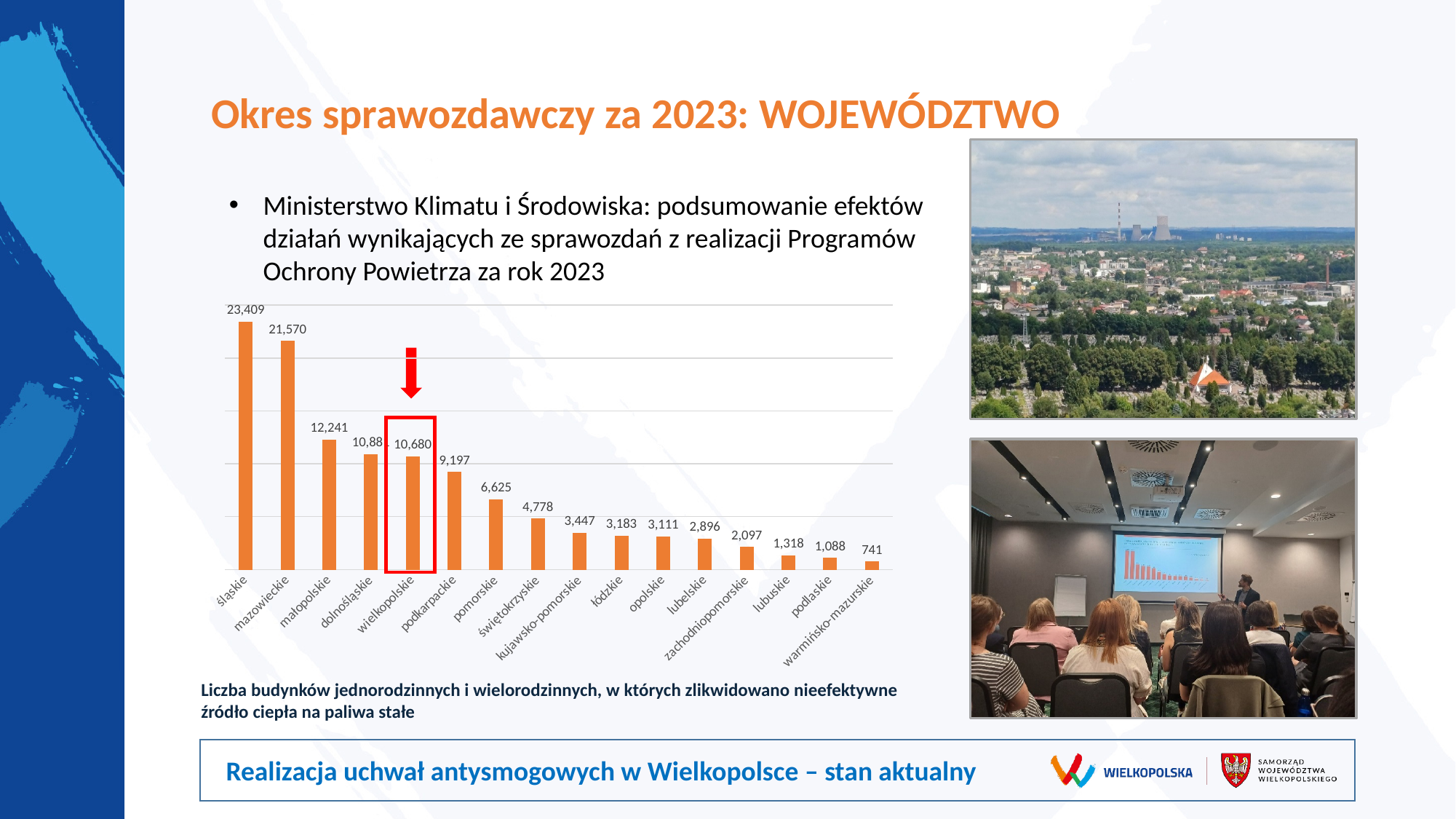
Which has a larger value, pomorskie or świętokrzyskie? pomorskie What is the value for podkarpackie in the bar chart? 9,197 How many voivodeships are shown in the bar chart? 16 What is the value for warmińsko-mazurskie in the bar chart? 741 Do the values rise or fall from left to right along the x axis? fall What is the value for wielkopolskie in the bar chart? 10,680 Which voivodeship has the lowest value in the bar chart? warmińsko-mazurskie What is the difference between the values for śląskie and mazowieckie? 1,839 What is the difference between the values for wielkopolskie and podkarpackie? 1,483 What is the value for śląskie in the bar chart? 23,409 What kind of chart is shown on the slide? bar chart Which voivodeship has the highest value in the bar chart? śląskie